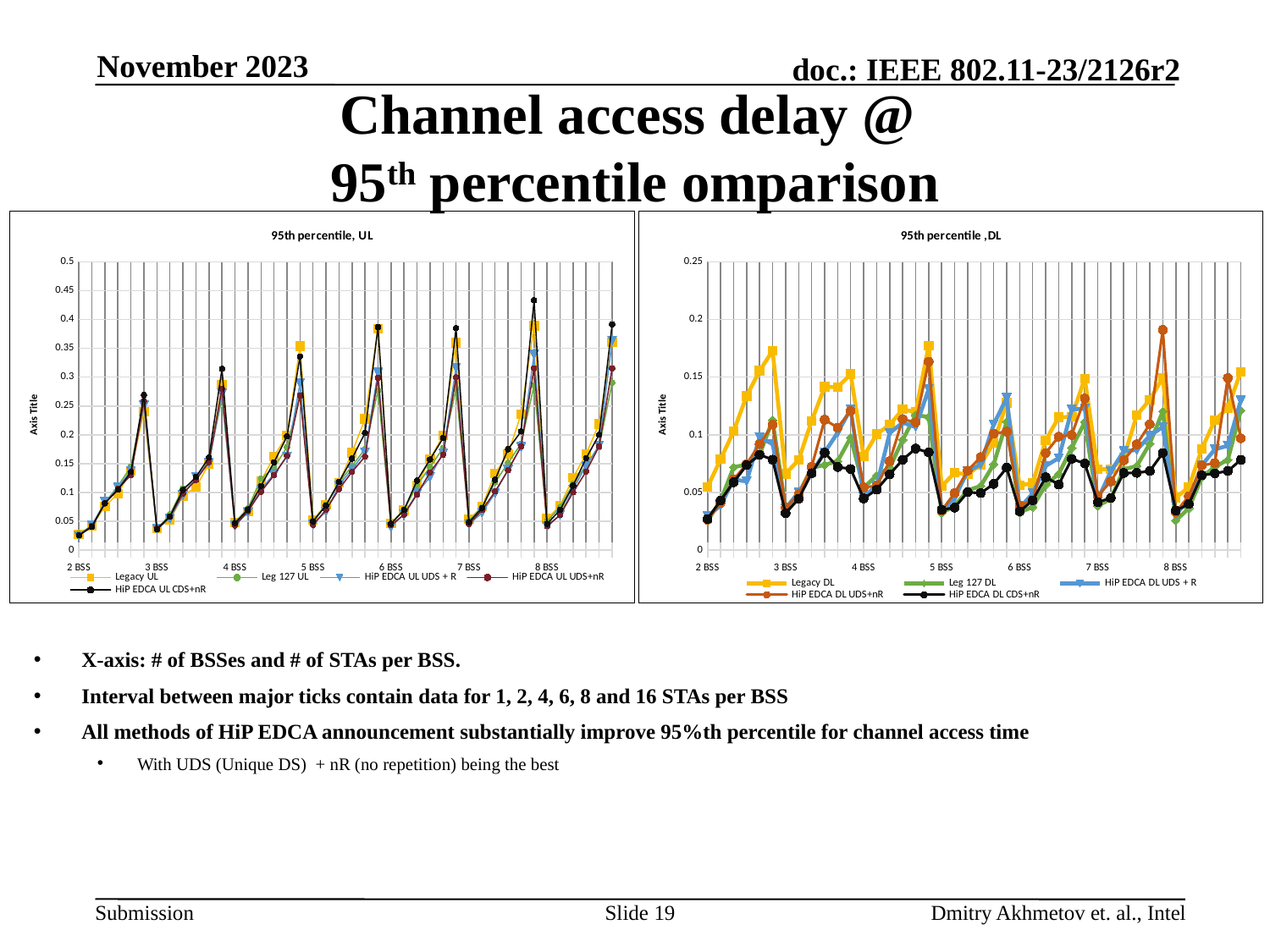
In the '95th percentile ,DL' chart, is the highest value of the HiP EDCA DL CDS+nR series greater or less than 0.1? less How many series does the legend of the '95th percentile ,DL' chart list? 5 How many series does the legend of the '95th percentile, UL' chart list? 5 What kind of chart is the '95th percentile ,DL' chart? line chart In the '95th percentile, UL' chart, is the highest value of the Legacy UL series in the 5 BSS interval greater or less than 0.4? less What is the title of the left chart on the slide? 95th percentile, UL What is the highest value shown on the y axis of the '95th percentile ,DL' chart? 0.25 What kind of chart is the '95th percentile, UL' chart? line chart How many BSS categories are labelled on the x axis of the '95th percentile, UL' chart? 7